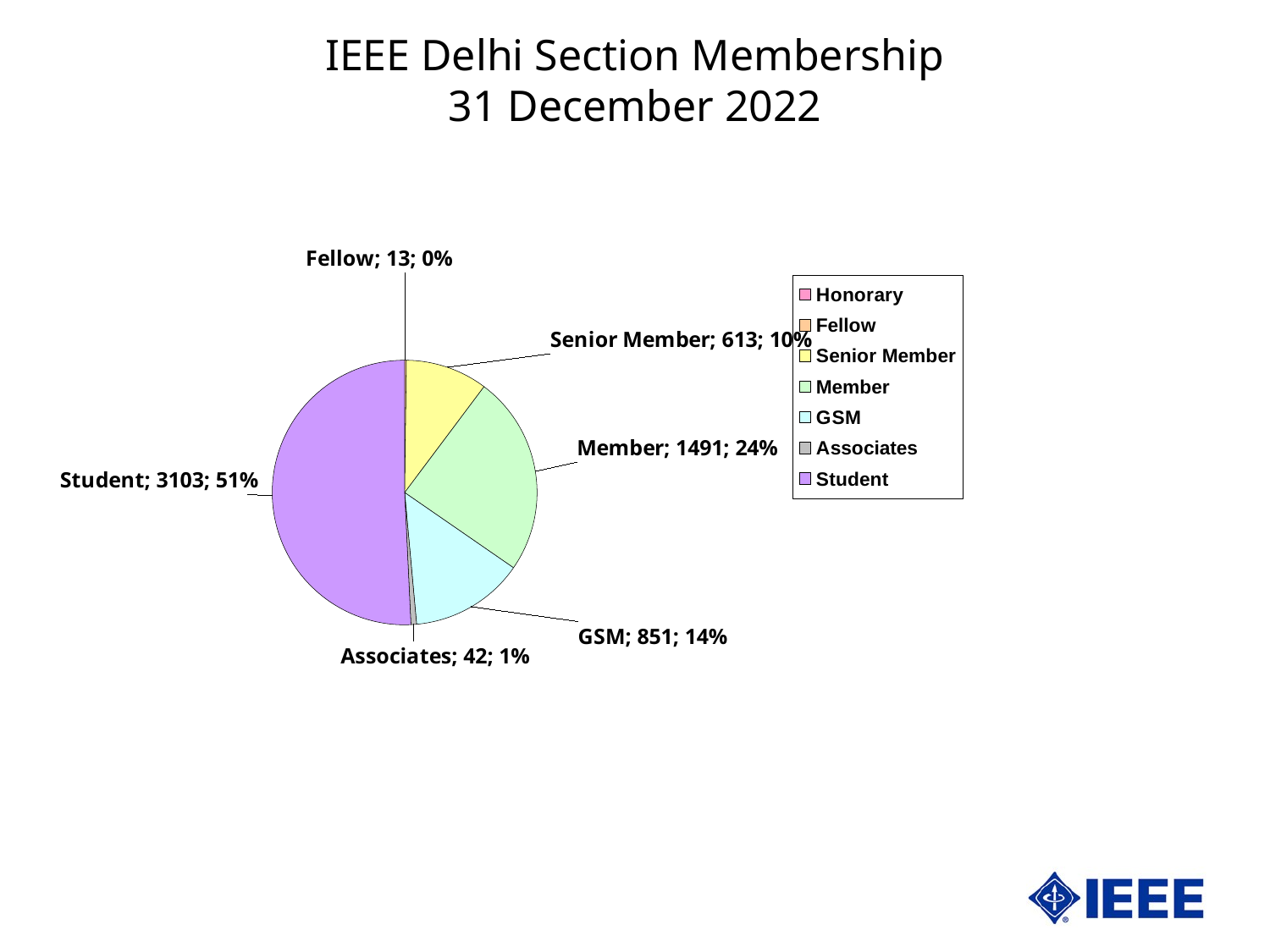
Which is larger, the Member count or the GSM count? Member What percentage share of the pie does the Member category have? 24% How many entries does the legend list? 7 What percentage share of the pie does the Student category have? 51% How many members does the Student category have? 3103 What kind of chart is shown on the slide? pie chart What is the title of the chart? IEEE Delhi Section Membership 31 December 2022 What is the count for GSM? 851 What is the difference between the Student count and the Member count? 1612 What is the count for Associates? 42 Which category has the largest share of the pie? Student What is the count for Senior Member? 613